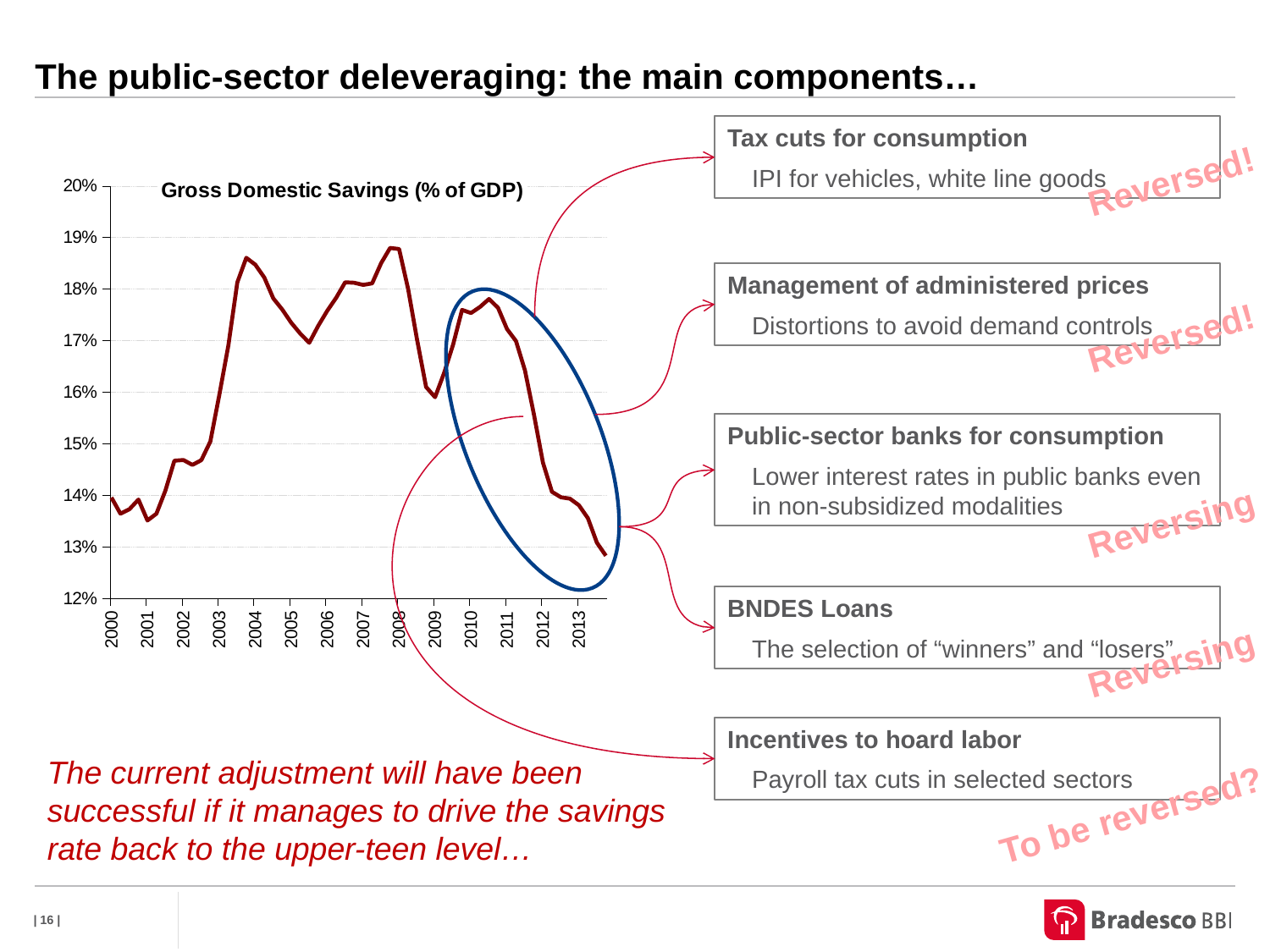
Is the value at the end of the series in 2013 greater or less than 14%? less Is the value at the start of 2000 greater or less than 15%? less Does the savings rate rise or fall between 2010 and 2013? fall Is the value around 2010 greater or less than 16%? greater How many years are labeled on the x axis of the chart? 14 What kind of chart is shown on the slide? line chart What is the title of the chart on the slide? Gross Domestic Savings (% of GDP) What is the highest value shown on the y axis of the chart? 20% Does the savings rate rise or fall between 2001 and 2004? rise